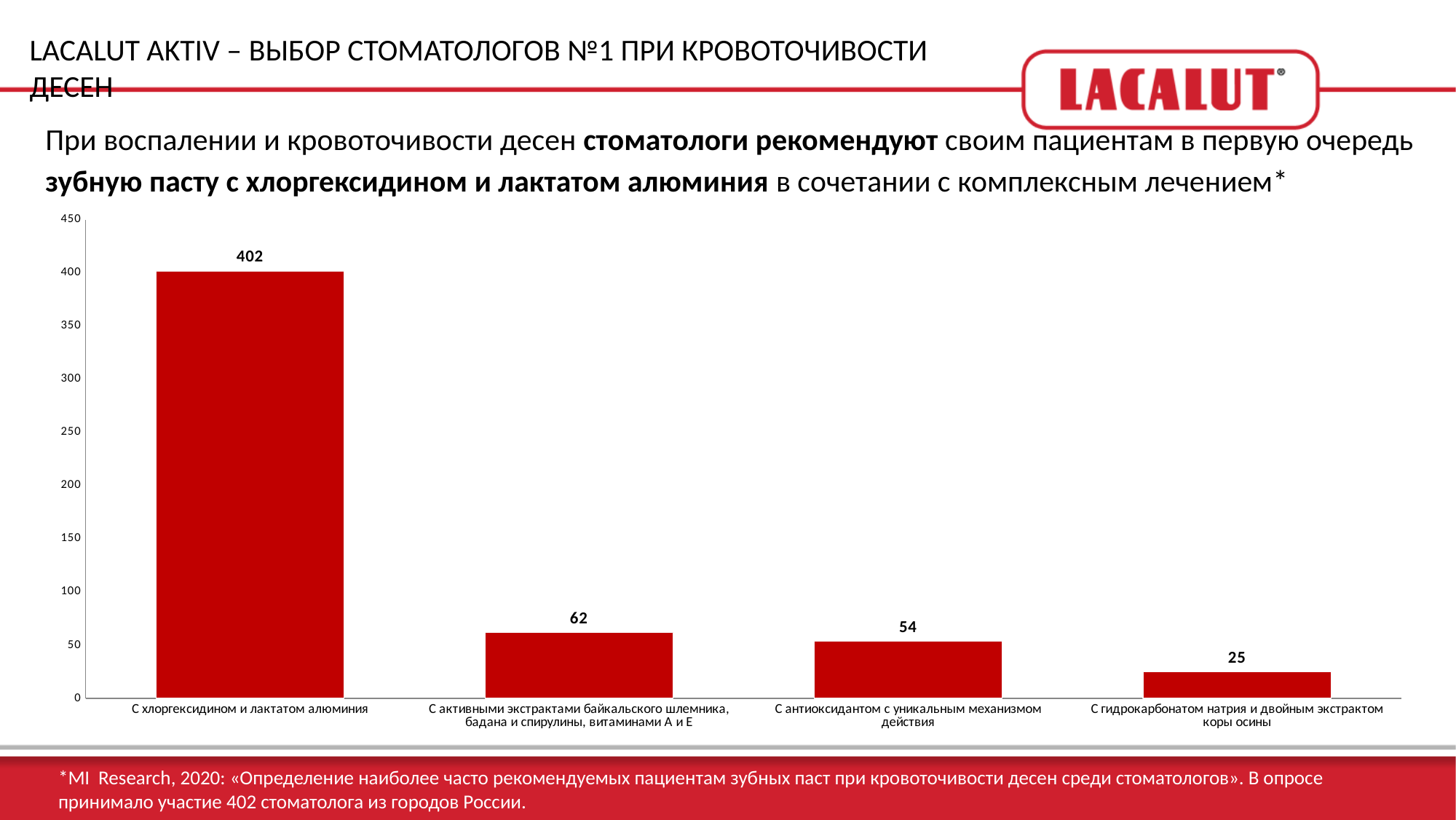
What is the difference between the values for 'С хлоргексидином и лактатом алюминия' and 'С активными экстрактами байкальского шлемника, бадана и спирулины, витаминами А и Е'? 340 What is the difference between the values for 'С антиоксидантом с уникальным механизмом действия' and 'С гидрокарбонатом натрия и двойным экстрактом коры осины'? 29 Which category has the lowest value? С гидрокарбонатом натрия и двойным экстрактом коры осины How many categories are shown in the chart? 4 What is the value for the category 'С антиоксидантом с уникальным механизмом действия'? 54 What is the value for the category 'С гидрокарбонатом натрия и двойным экстрактом коры осины'? 25 Which category has the highest value? С хлоргексидином и лактатом алюминия What is the value for the category 'С активными экстрактами байкальского шлемника, бадана и спирулины, витаминами А и Е'? 62 Do the values rise or fall from left to right along the x axis? Fall Which is larger: the value for 'С активными экстрактами байкальского шлемника, бадана и спирулины, витаминами А и Е' or the value for 'С антиоксидантом с уникальным механизмом действия'? С активными экстрактами байкальского шлемника, бадана и спирулины, витаминами А и Е What kind of chart is shown on the slide? Bar chart What is the value for the category 'С хлоргексидином и лактатом алюминия'? 402